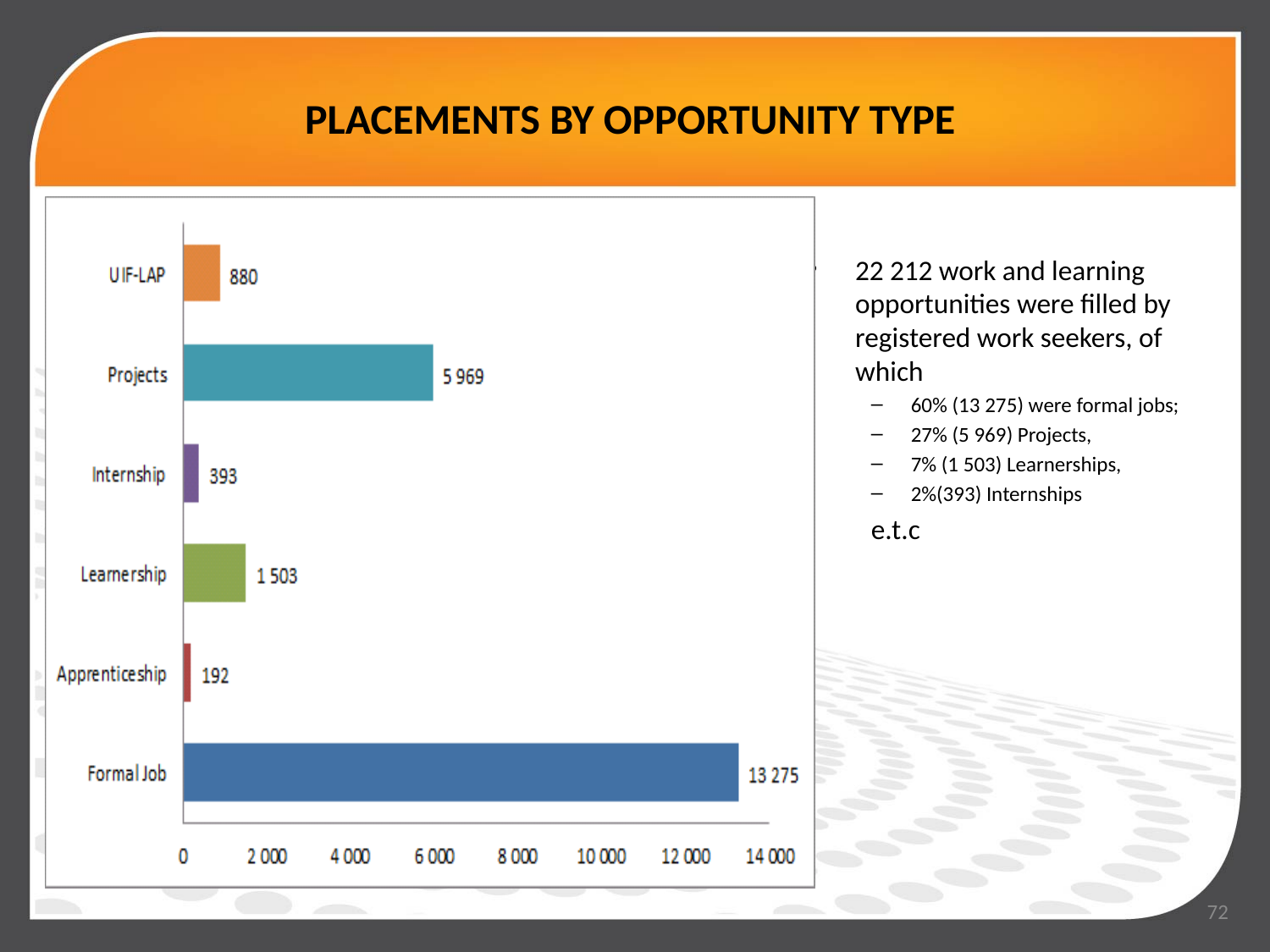
What is the difference between the values for Formal Job and Projects? 7 306 What is the value for Formal Job? 13 275 Which opportunity type has the lowest number of placements? Apprenticeship What is the difference between the values for Learnership and Internship? 1 110 Which is larger, the value for UIF-LAP or the value for Internship? UIF-LAP What is the value for UIF-LAP? 880 What kind of chart is shown on the slide? bar chart What is the value for Projects? 5 969 How many opportunity types are shown in the chart? 6 What is the value for Apprenticeship? 192 Which opportunity type has the highest number of placements? Formal Job Is the value for Projects greater or less than 6 000? less